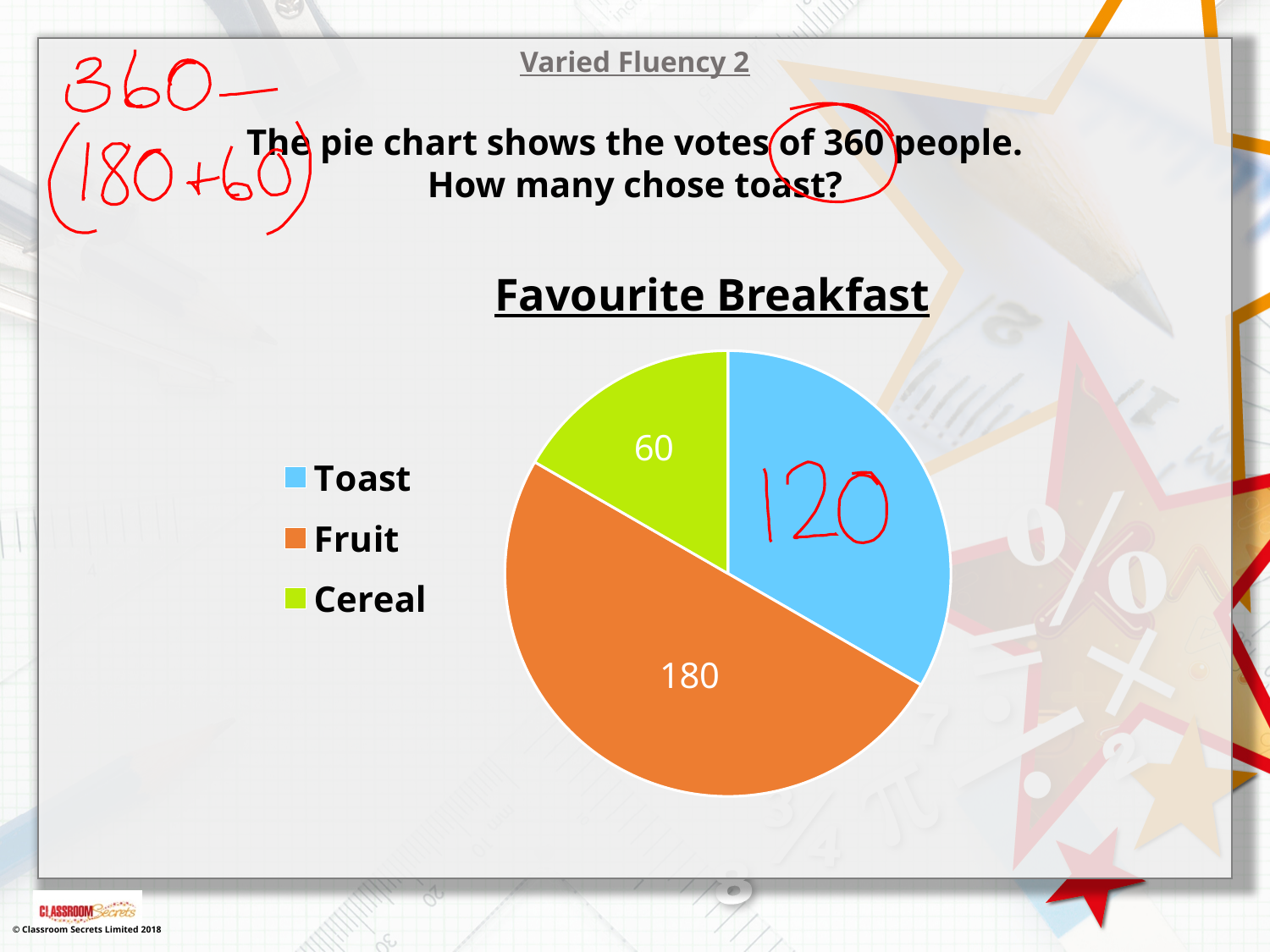
What is the value shown for Cereal in the Favourite Breakfast pie chart? 60 How many categories are shown in the Favourite Breakfast pie chart? 3 What share of the pie does the Fruit slice represent, given the chart shows the votes of 360 people? 50% What kind of chart is shown on the slide? Pie chart Which category has the largest slice in the Favourite Breakfast pie chart? Fruit What is the value shown for Fruit in the Favourite Breakfast pie chart? 180 Which category has the smallest slice in the Favourite Breakfast pie chart? Cereal Which is larger, the slice for Toast or the slice for Cereal? Toast What is the difference between the values for Fruit and Cereal? 120 How many entries does the legend of the pie chart list? 3 What is the title of the pie chart? Favourite Breakfast Which is larger, the slice for Toast or the slice for Fruit? Fruit